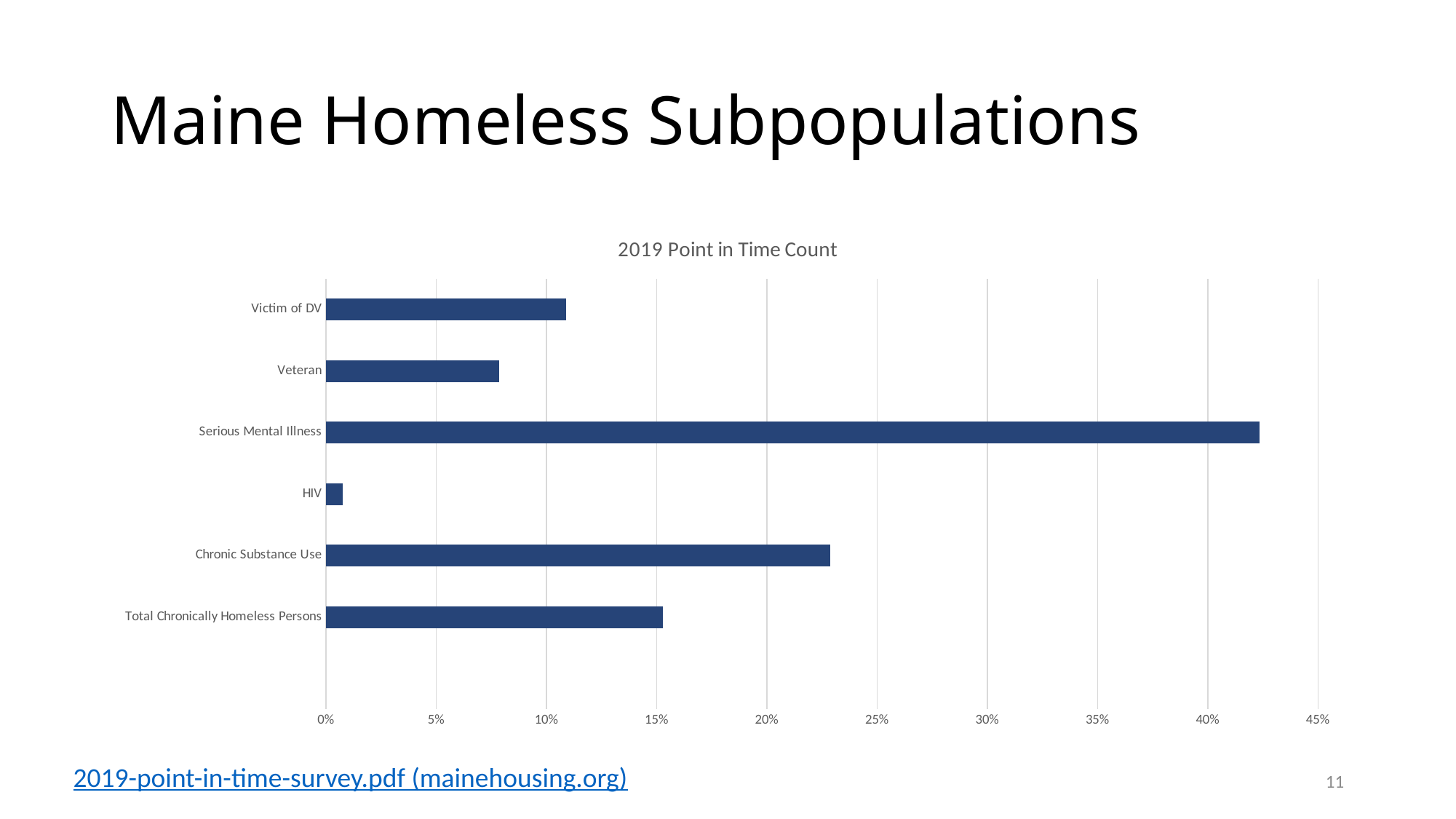
Is the value for HIV greater or less than 5%? less What kind of chart is shown on the slide? bar chart Which is larger, the value for Chronic Substance Use or the value for Total Chronically Homeless Persons? Chronic Substance Use Which is larger, the value for Victim of DV or the value for Veteran? Victim of DV Which category has the lowest value? HIV How many subpopulation categories are plotted in the chart? 6 What is the highest value shown on the horizontal axis? 45% What is the title of the chart? 2019 Point in Time Count Is the value for Chronic Substance Use greater or less than 20%? greater Is the value for Veteran greater or less than 10%? less Which category has the highest value? Serious Mental Illness